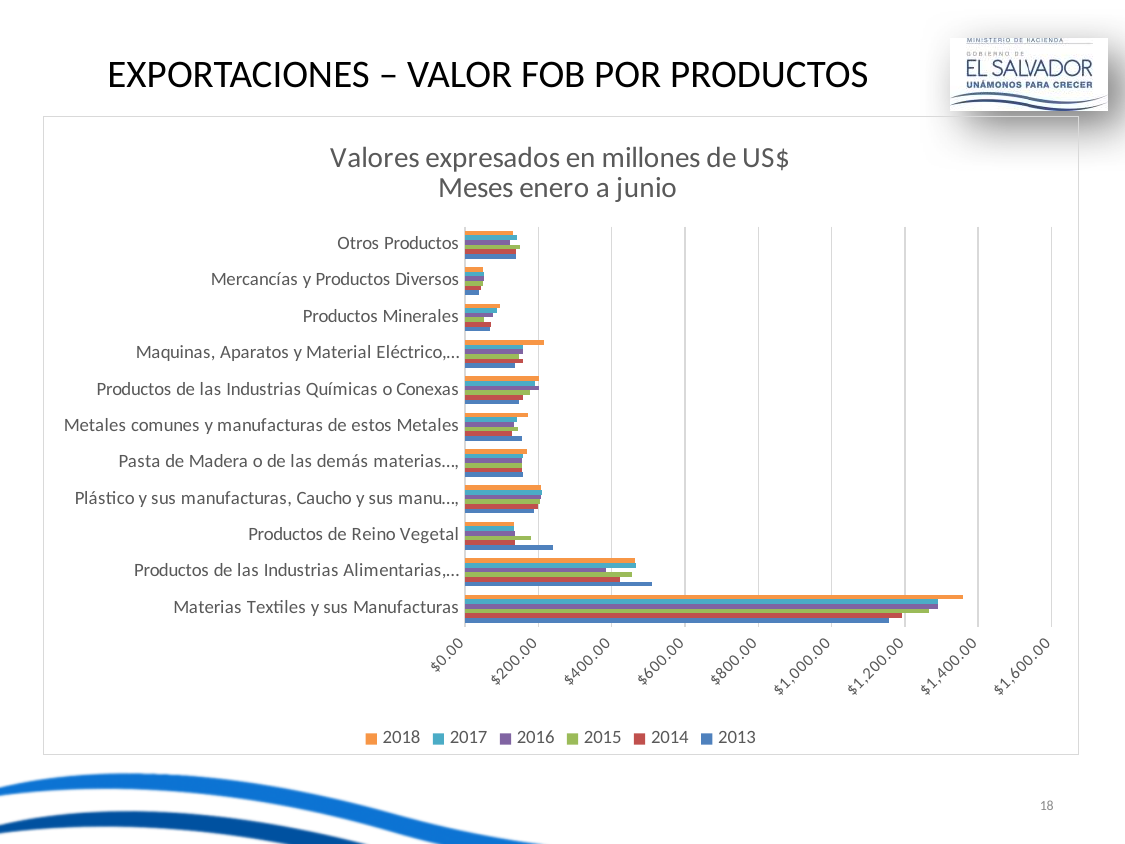
Which product category has the lowest export values? Mercancías y Productos Diversos Which product category has the highest export values? Materias Textiles y sus Manufacturas For Materias Textiles y sus Manufacturas, which year has the larger value, 2018 or 2013? 2018 Is the 2018 value for Productos de las Industrias Alimentarias greater or less than $600.00? less Is the 2013 value for Productos de Reino Vegetal greater or less than $200.00? greater How many product categories are listed on the chart? 11 What is the title of the chart? Valores expresados en millones de US$ Meses enero a junio Is the 2018 value for Materias Textiles y sus Manufacturas greater or less than $1,200.00? greater For Productos de Reino Vegetal, which year has the larger value, 2013 or 2018? 2013 How many series does the legend list? 6 What kind of chart is shown on the slide? bar chart